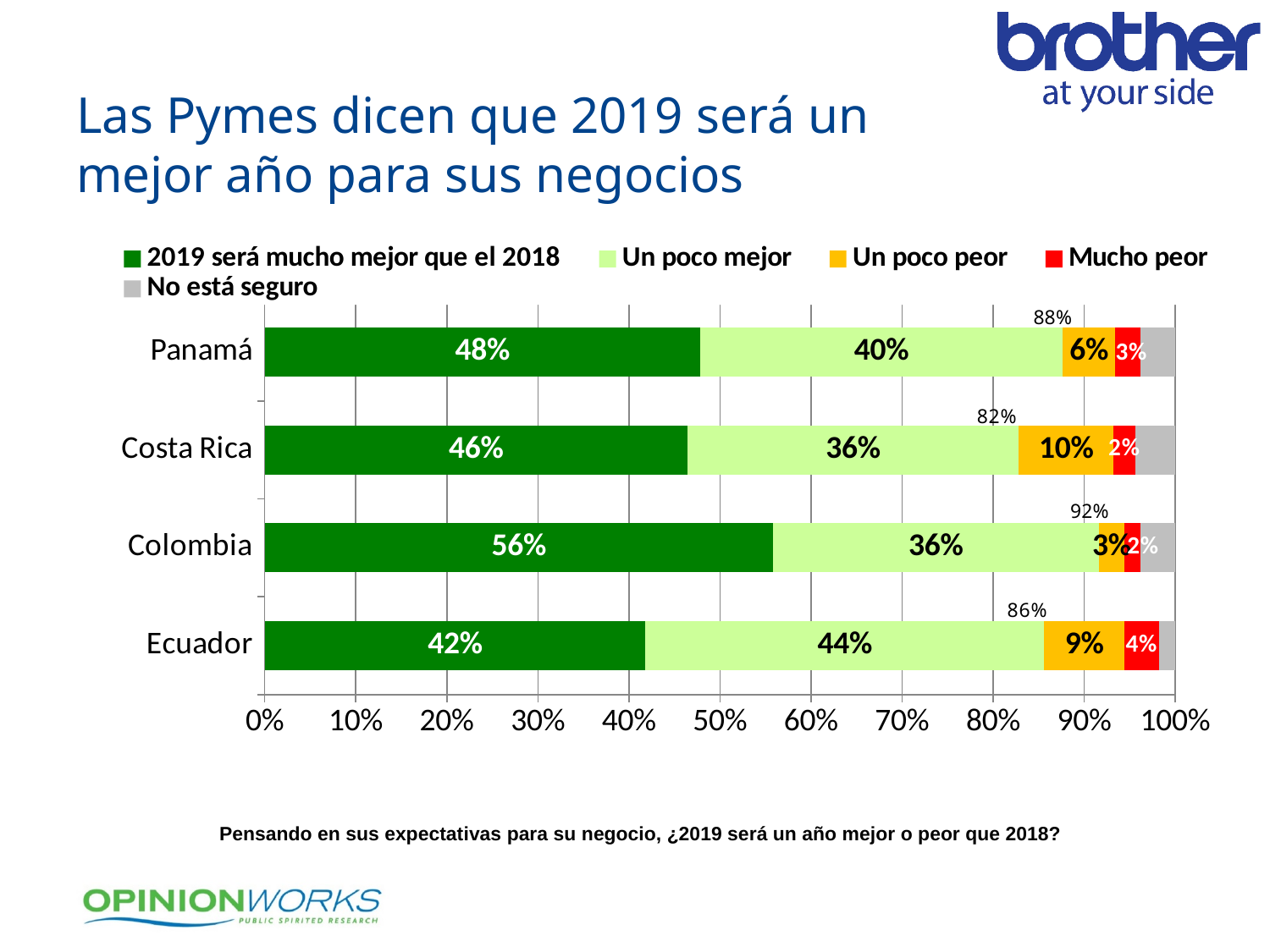
Which country has the highest share saying 2019 será mucho mejor que el 2018? Colombia Which is larger: the 'Un poco peor' value for Costa Rica or for Ecuador? Costa Rica What is the 'Un poco mejor' value for Ecuador? 44% What combined percentage is printed above the Colombia bar for the two 'mejor' categories? 92% What percentage of Pymes in Panamá say 2019 será mucho mejor que el 2018? 48% How many countries are shown in the chart? 4 What is the 'Mucho peor' value for Ecuador? 4% What is the 'Un poco peor' value for Costa Rica? 10% How many series does the legend list? 5 Which country has the lowest share saying 2019 será mucho mejor que el 2018? Ecuador What is the difference between Colombia's and Ecuador's 'mucho mejor' values? 14% What kind of chart is shown on the slide? Stacked bar chart